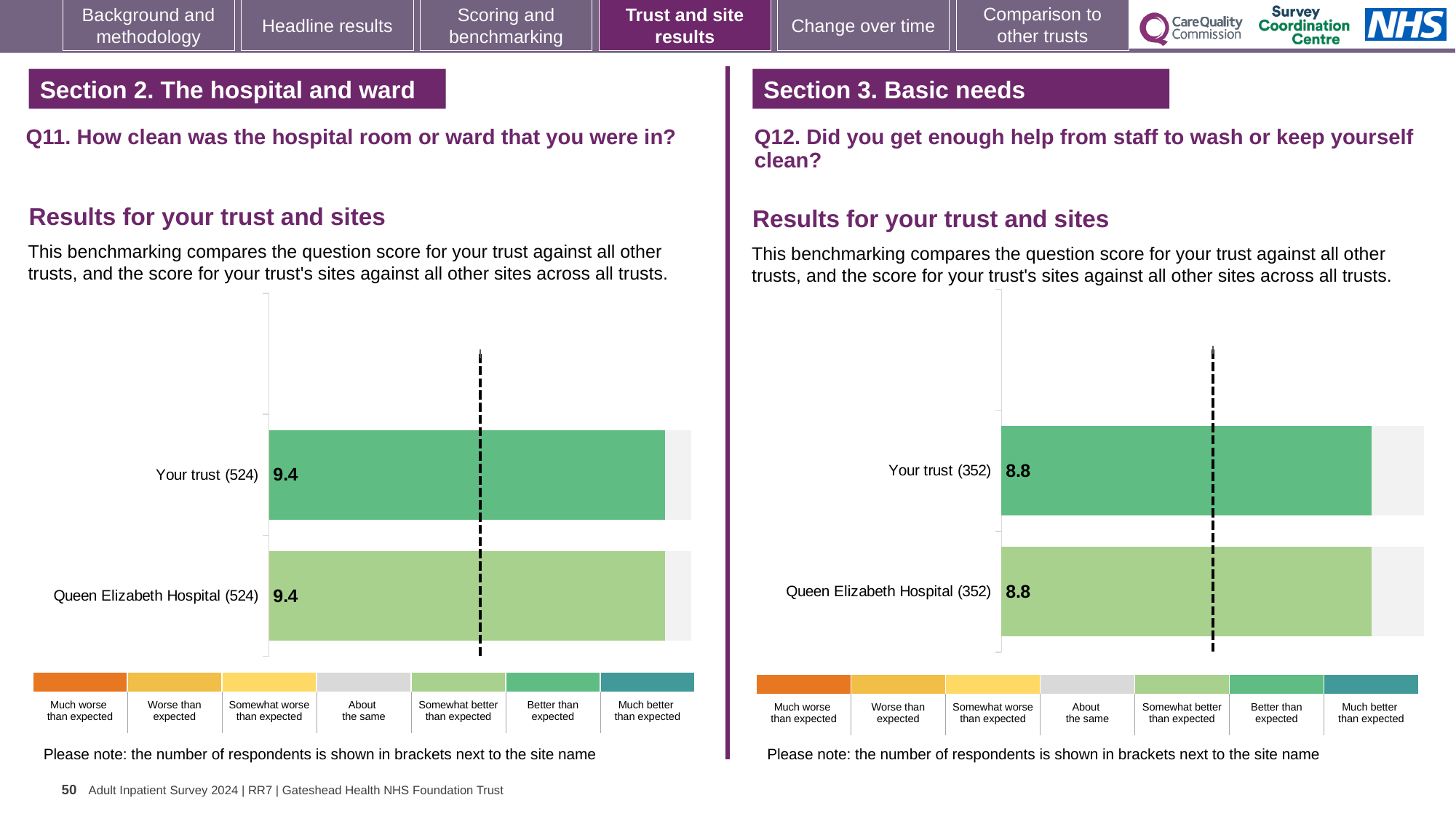
In the Q12 chart on the right, what is the score for Your trust (352)? 8.8 Is the score for Your trust in the Q11 chart on the left larger than the score for Your trust in the Q12 chart on the right? Yes In the Q11 chart on the left, what is the score for Queen Elizabeth Hospital (524)? 9.4 What kind of chart is used for the Q11 results on the left? Bar chart How many bars are plotted in the Q11 chart on the left? 2 In the Q11 chart on the left, what is the difference between the score for Your trust and the score for Queen Elizabeth Hospital? 0 In the Q11 chart on the left, how many respondents are shown in brackets next to Your trust? 524 In the Q11 chart on the left, what is the score for Your trust (524)? 9.4 In the Q12 chart on the right, how many respondents are shown in brackets next to Queen Elizabeth Hospital? 352 In the Q12 chart on the right, what is the difference between the score for Your trust and the score for Queen Elizabeth Hospital? 0 How many bars are plotted in the Q12 chart on the right? 2 In the Q12 chart on the right, what is the score for Queen Elizabeth Hospital (352)? 8.8